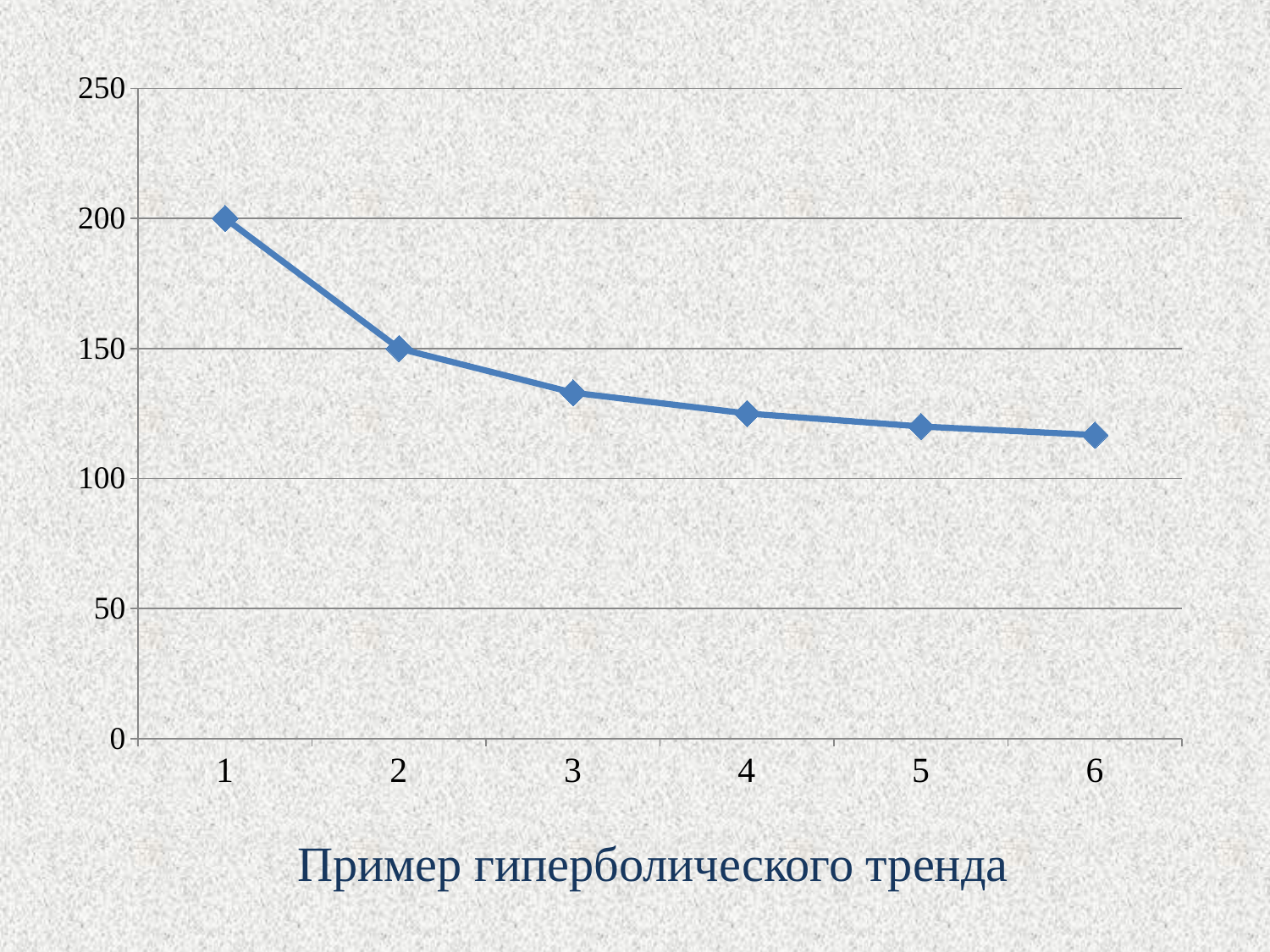
What is the caption written below the chart? Пример гиперболического тренда Which is larger, the value at x = 2 or the value at x = 5? x = 2 What type of chart is shown on the slide? line chart What is the value at x = 1? 200 What is the value at x = 2? 150 Is the value at x = 4 greater or less than 150? less How many data points are plotted on the line? 6 What is the difference between the values at x = 1 and x = 2? 50 Do the values rise or fall as x increases from 1 to 6? fall Is the value at x = 3 greater or less than 150? less Is the value at x = 6 greater or less than 100? greater At which x value is the plotted value highest? 1